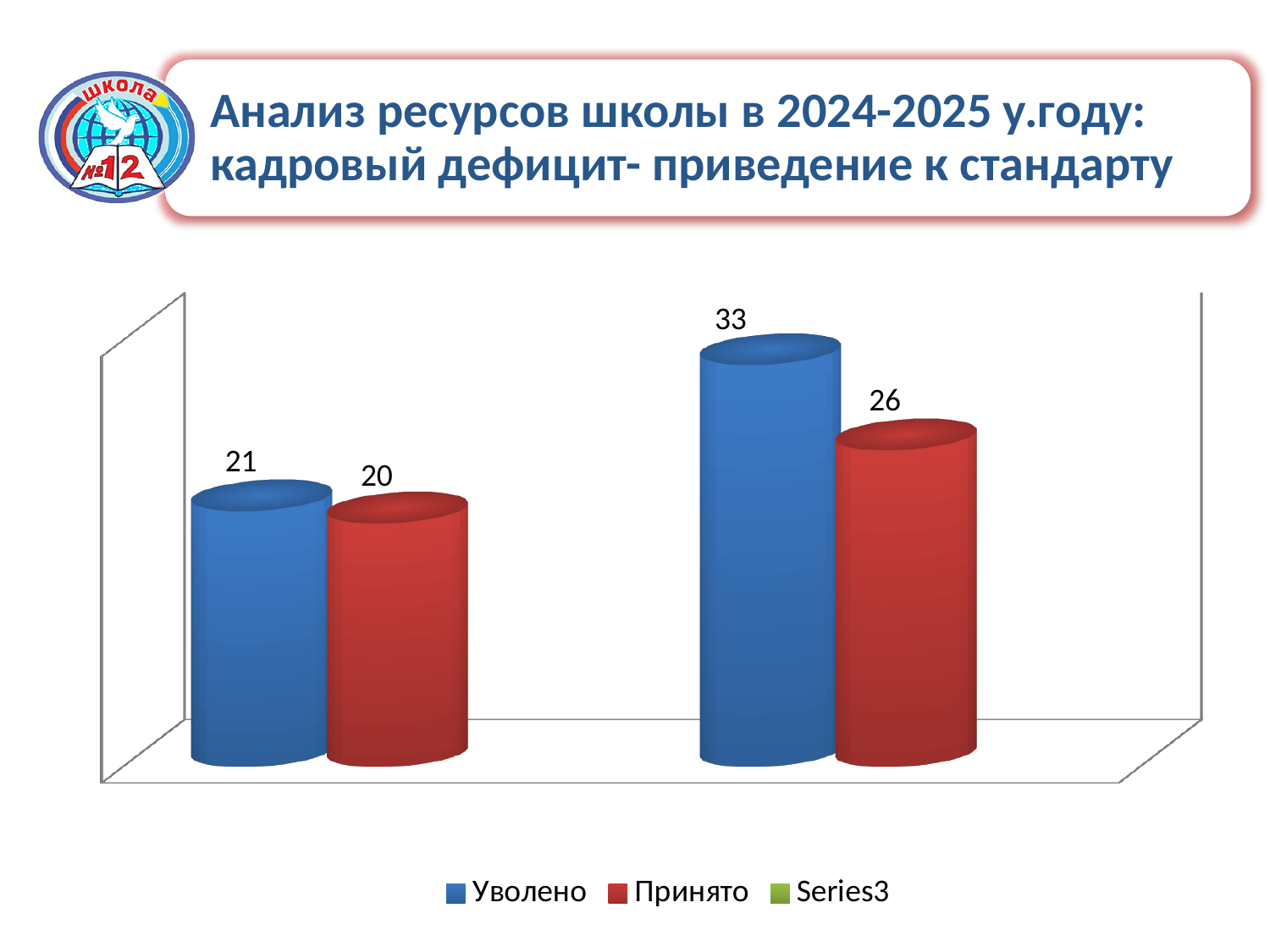
What is the difference between the Уволено and Принято values in the right group? 7 What is the difference between the Уволено values of the right group and the left group? 12 What is the value of the Принято bar in the right group? 26 How many series does the legend list? 3 Which bar has the highest value on the chart? Уволено in the right group (33) What is the value of the Уволено bar in the right group? 33 What is the value of the Уволено bar in the left group? 21 What kind of chart is shown on the slide? bar chart Which bar has the lowest value on the chart? Принято in the left group (20) In the right group, which is larger: Уволено or Принято? Уволено What is the value of the Принято bar in the left group? 20 Which legend entry is shown in blue? Уволено